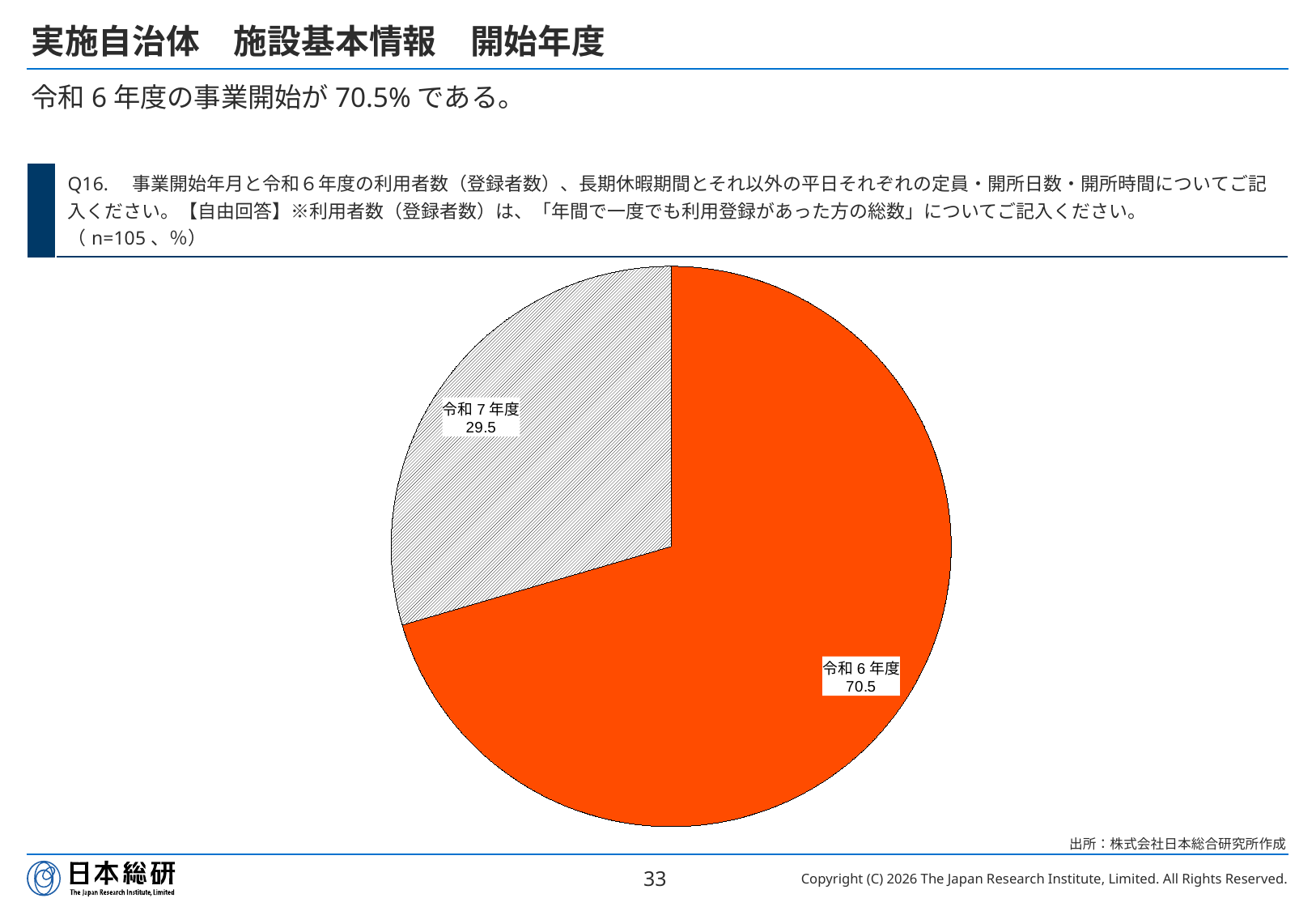
Which is larger, the value for 令和6年度 or 令和7年度? 令和6年度 What is the sample size (n) stated for the chart? 105 How many slices does the pie chart have? 2 What is the value shown for 令和6年度? 70.5 What is the value shown for 令和7年度? 29.5 What kind of chart is shown on the slide? pie chart Which category has the largest slice of the pie? 令和6年度 What share of the pie does 令和7年度 represent? 29.5% Which category has the smallest slice of the pie? 令和7年度 What is the difference between the values for 令和6年度 and 令和7年度? 41.0 Which slice is drawn with a hatched pattern rather than solid orange? 令和7年度